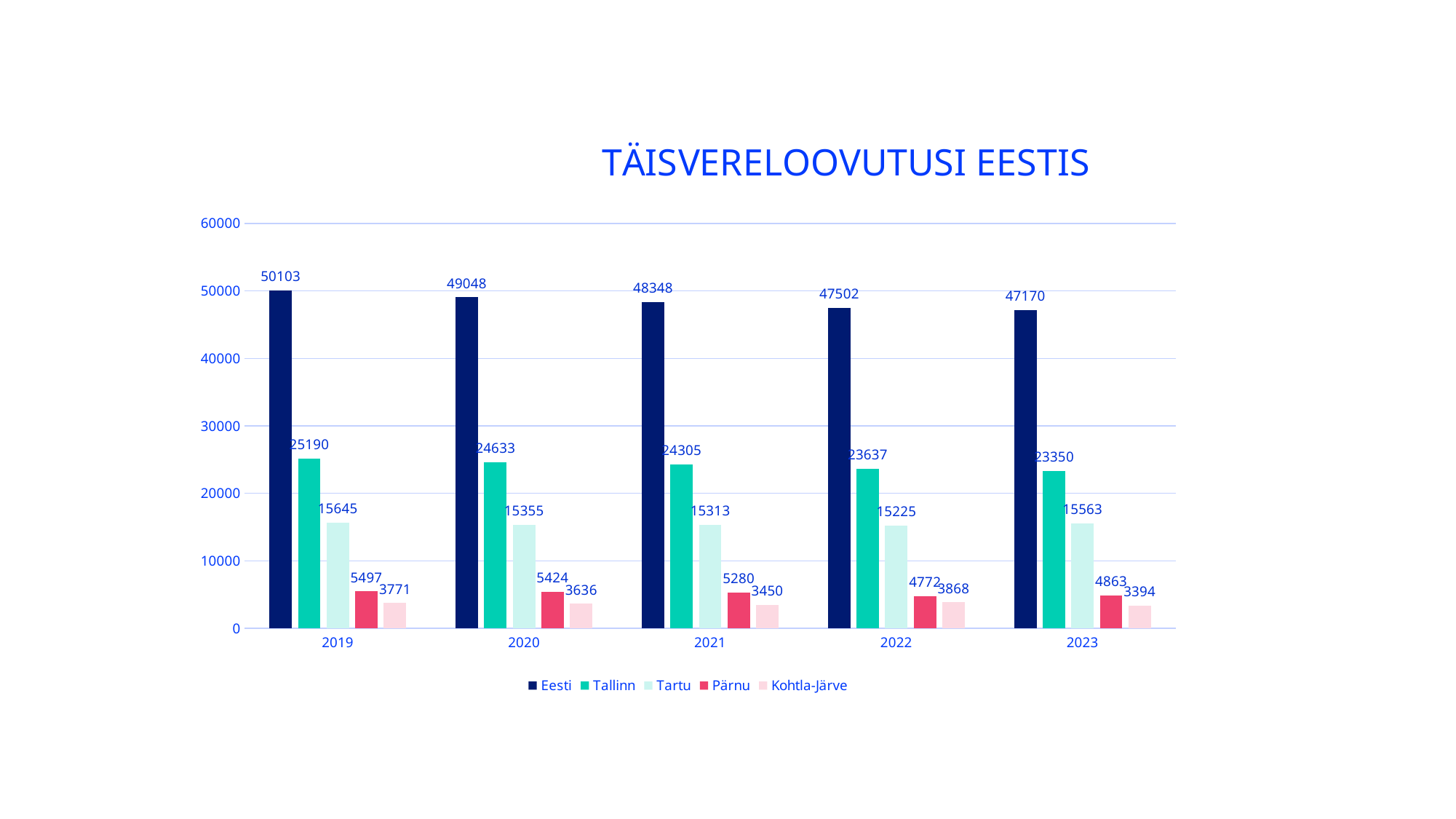
What is the value for Kohtla-Järve in 2021? 3450 What is the value for Eesti in 2019? 50103 In which year is the Pärnu value lowest? 2022 How many years are shown on the x axis? 5 What is the value for Tallinn in 2023? 23350 What kind of chart is shown? bar chart Is the value for Tallinn in 2020 greater or less than 20000? greater Which is larger, the Tartu value in 2023 or the Tartu value in 2022? 2023 In which year is the Eesti value highest? 2019 Does the Eesti value rise or fall from 2019 to 2023? fall What is the difference between the Eesti values for 2019 and 2023? 2933 How many series does the legend list? 5